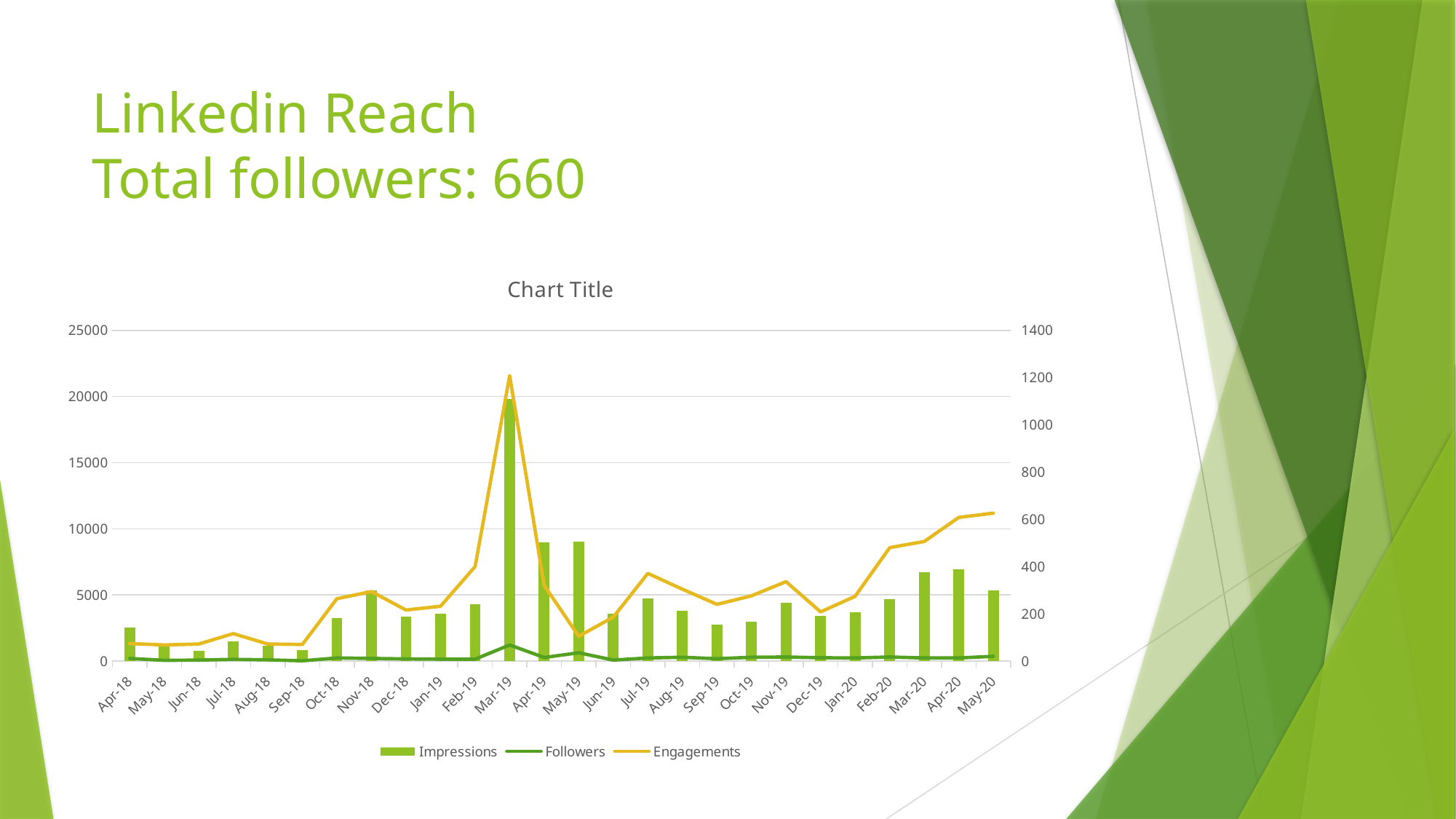
Is the Impressions value for Mar-19 greater or less than 15000? greater Which month has more Impressions, Apr-20 or Jan-20? Apr-20 Do Engagements rise or fall from Jan-20 to May-20? Rise What are the three entries in the chart legend? Impressions, Followers, Engagements How many months are shown along the x axis? 26 Is the Impressions value for Apr-18 greater or less than 5000? less In which month are Impressions highest? Mar-19 How many series does the legend list? 3 What kind of chart is shown on the slide? A combined bar and line chart Is the Impressions value for Apr-19 greater or less than 10000? less In which month are Engagements highest? Mar-19